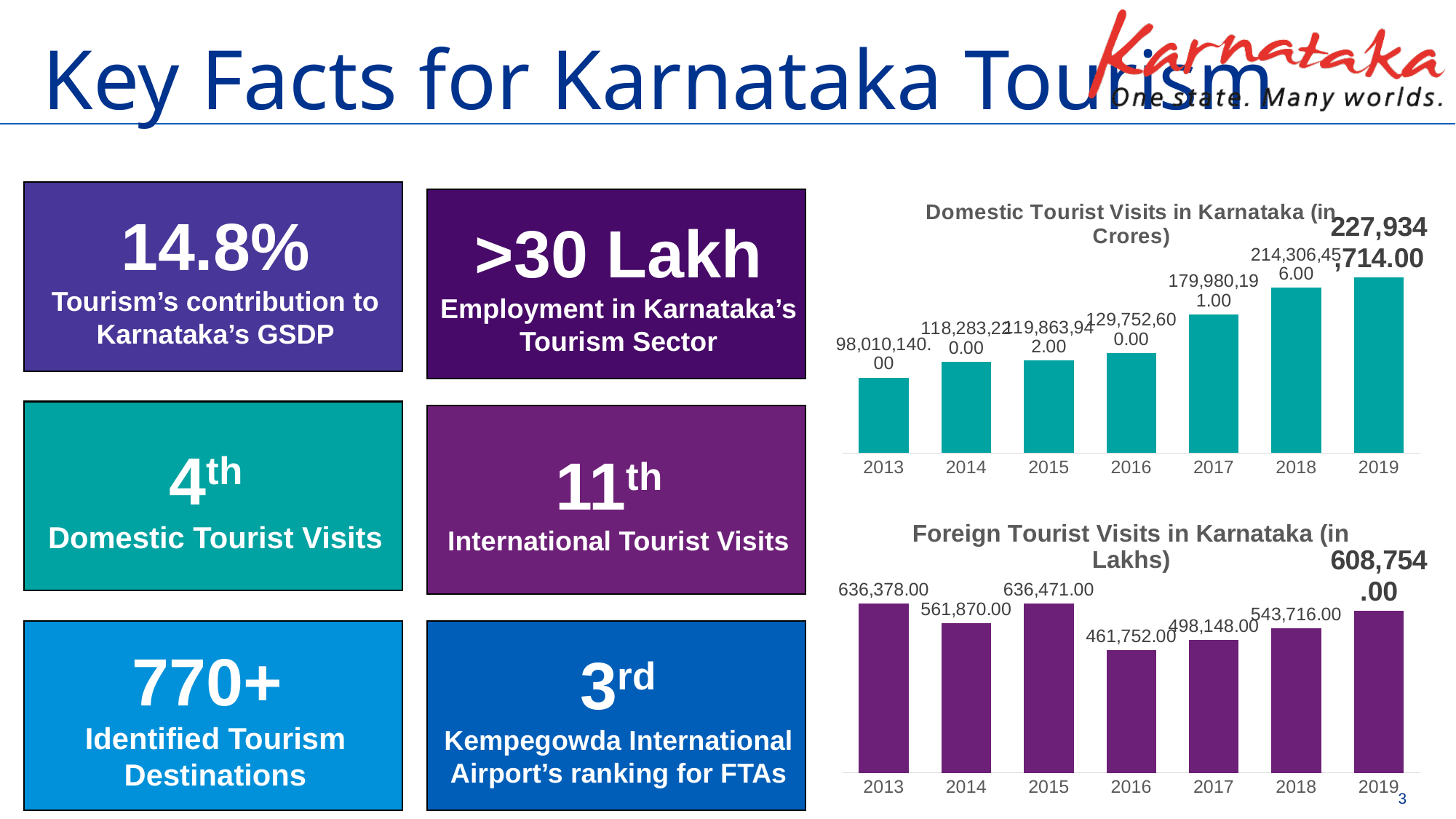
In the Domestic Tourist Visits in Karnataka chart, do the values rise or fall from 2013 to 2019? rise In the Domestic Tourist Visits in Karnataka chart, what is the value for 2019? 227,934,714.00 In the Domestic Tourist Visits in Karnataka chart, what is the value for 2013? 98,010,140.00 In the Domestic Tourist Visits in Karnataka chart, which year has the lowest value? 2013 In the Foreign Tourist Visits in Karnataka chart, which year has the lowest value? 2016 In the Foreign Tourist Visits in Karnataka chart, what is the value for 2016? 461,752.00 In the Foreign Tourist Visits in Karnataka chart, which is larger, the value for 2014 or the value for 2017? 2014 In the Domestic Tourist Visits in Karnataka chart, which year has the highest value? 2019 In the Foreign Tourist Visits in Karnataka chart, what is the difference between the 2013 and 2016 values? 174,626.00 How many years are shown in the Foreign Tourist Visits in Karnataka chart? 7 In the Domestic Tourist Visits in Karnataka chart, what is the difference between the 2019 and 2018 values? 13,628,258.00 In the Foreign Tourist Visits in Karnataka chart, what is the value for 2019? 608,754.00